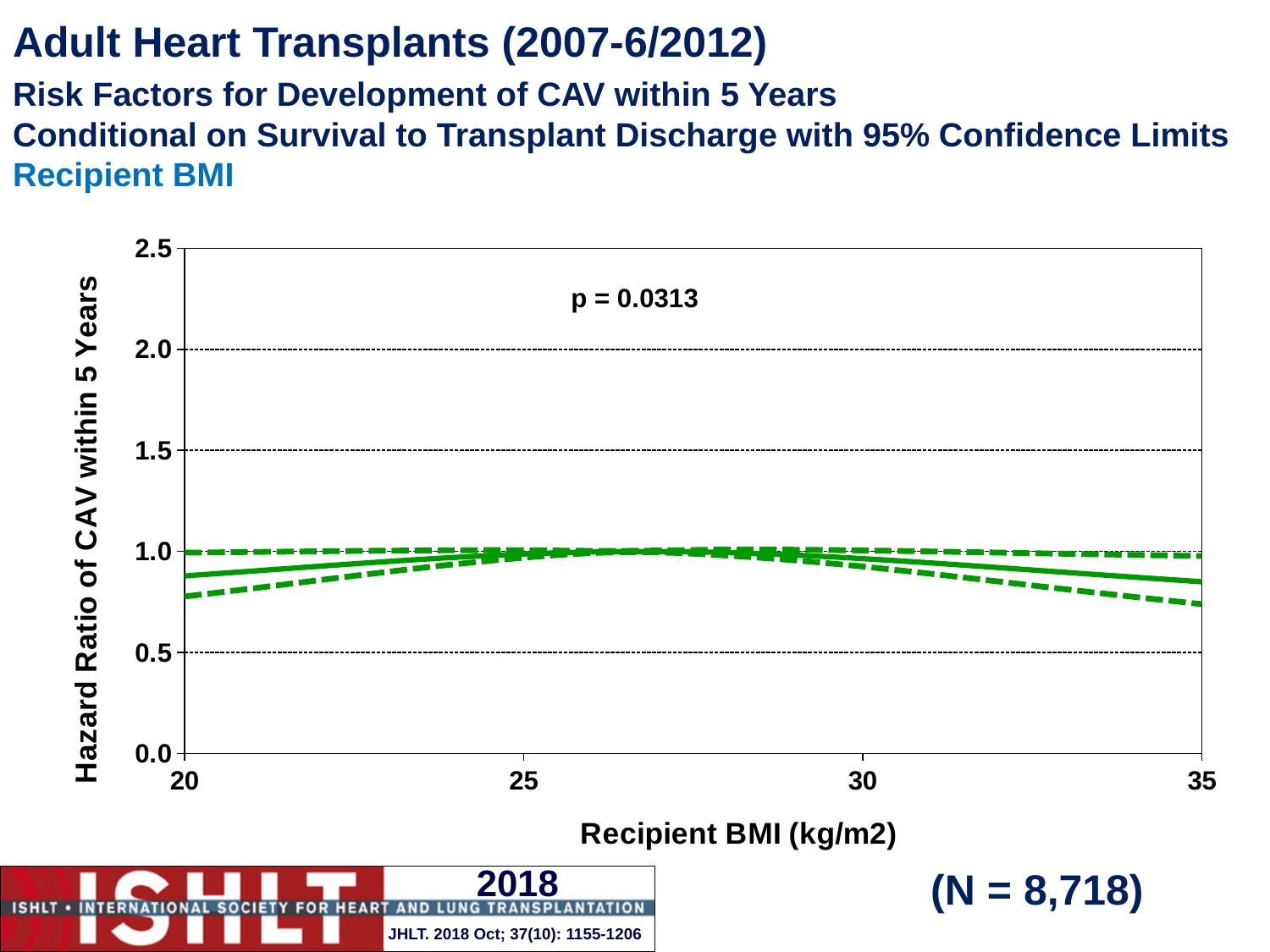
What p-value is printed on the chart? p = 0.0313 Is the hazard ratio of the solid line at a recipient BMI of 20 greater or less than 1.0? less Does the solid hazard ratio line rise or fall as recipient BMI increases from 20 to 25? rise What kind of chart is shown on the slide? line chart Is the lower dashed confidence limit at a recipient BMI of 35 greater or less than 0.5? greater How many tick labels are shown on the x axis? 4 Is the hazard ratio of the solid line at a recipient BMI of 35 greater or less than 1.0? less What is the highest value labelled on the y axis? 2.5 How many lines (solid and dashed) are plotted on the chart? 3 Does the solid hazard ratio line rise or fall as recipient BMI increases from 30 to 35? fall What is the sample size (N) shown on the slide? 8,718